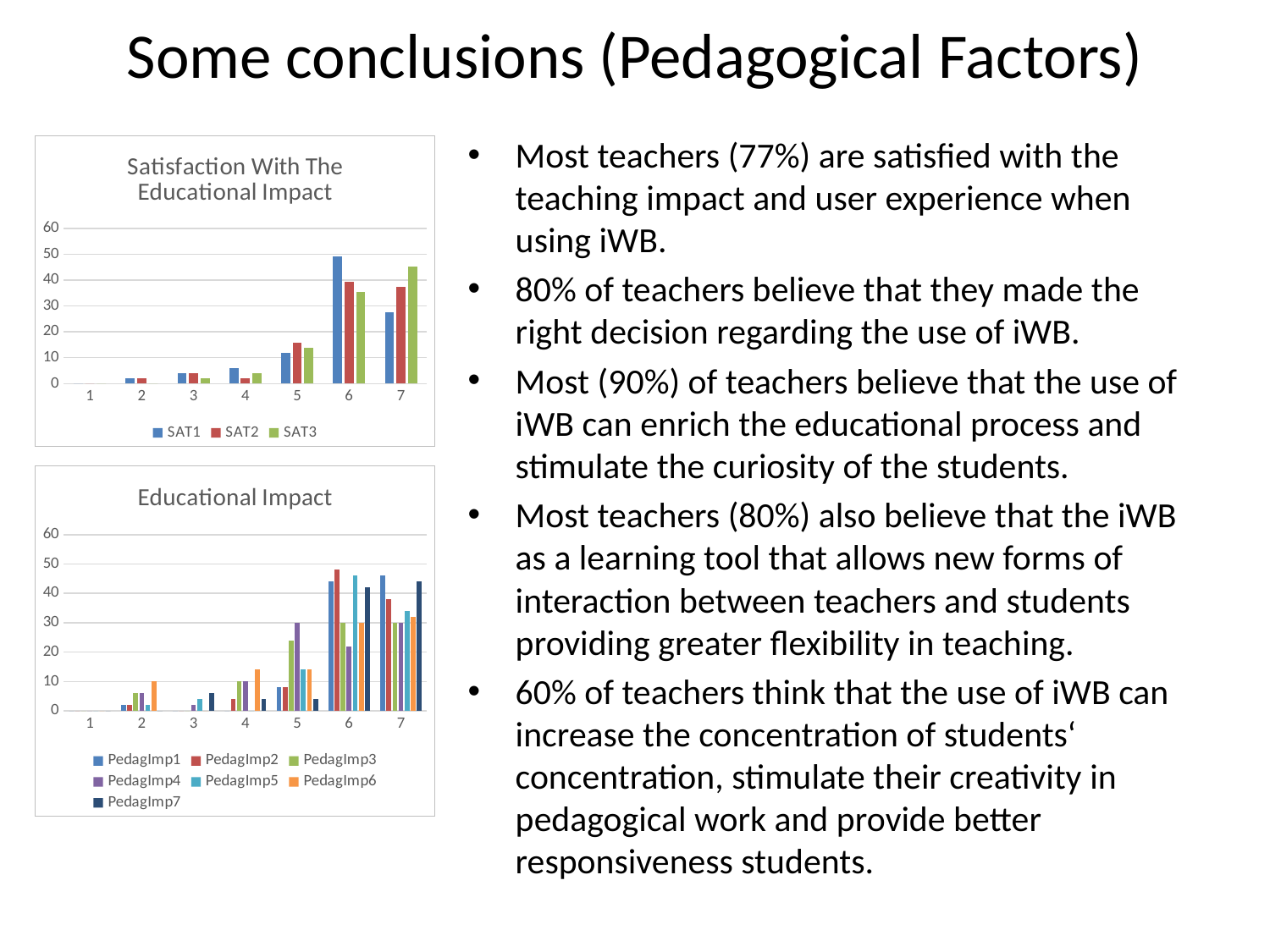
In the 'Satisfaction With The Educational Impact' chart, is the SAT1 value for category 6 greater or less than 40? greater In the 'Satisfaction With The Educational Impact' chart, for category 7, which is larger: SAT1 or SAT3? SAT3 In the 'Satisfaction With The Educational Impact' chart, is the SAT1 value for category 7 greater or less than 20? greater In the 'Educational Impact' chart, is the PedagImp4 value for category 6 greater or less than 30? less In the 'Educational Impact' chart, which category has the highest PedagImp2 value? 6 In the 'Satisfaction With The Educational Impact' chart, how many categories are on the x axis? 7 In the 'Satisfaction With The Educational Impact' chart, how many series does the legend list? 3 In the 'Educational Impact' chart, how many series does the legend list? 7 In the 'Educational Impact' chart, how many categories are on the x axis? 7 In the 'Satisfaction With The Educational Impact' chart, what kind of chart is shown? bar chart In the 'Satisfaction With The Educational Impact' chart, what are the legend entries? SAT1, SAT2, SAT3 In the 'Satisfaction With The Educational Impact' chart, which category has the highest SAT1 value? 6